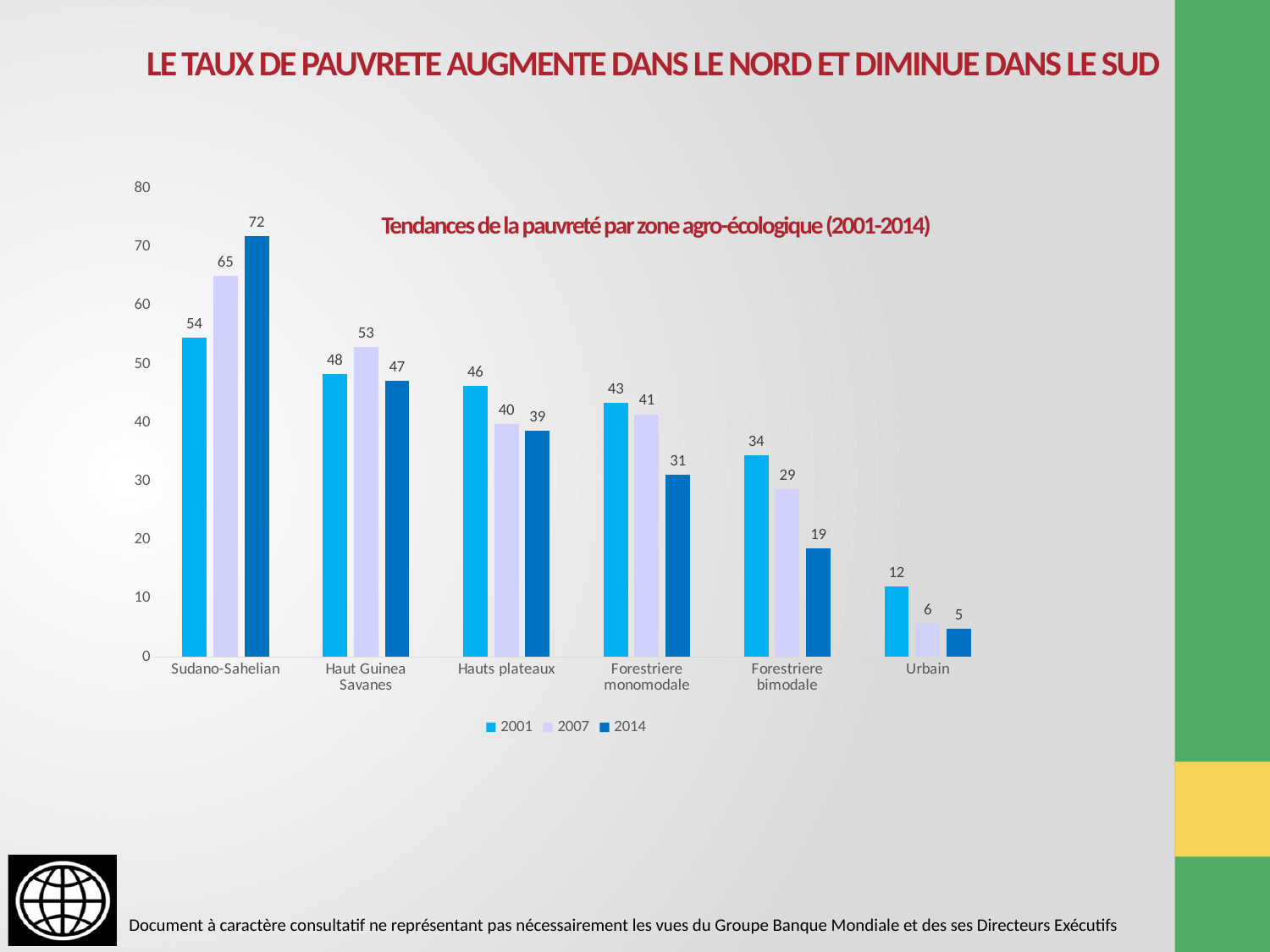
How many series does the legend list? 3 Which category has the highest value in 2014? Sudano-Sahelian What kind of chart is shown on the slide? bar chart How many categories are shown on the x axis? 6 Which is larger for Haut Guinea Savanes: the 2007 value or the 2014 value? 2007 What is the value for Forestriere bimodale in 2007? 29 What is the value for Urbain in 2001? 12 What is the difference between the 2014 and 2001 values for Sudano-Sahelian? 18 Which category has the lowest value in 2001? Urbain What is the value for Sudano-Sahelian in 2014? 72 What is the difference between the 2001 and 2014 values for Forestriere bimodale? 15 What is the title of the chart? Tendances de la pauvreté par zone agro-écologique (2001-2014)